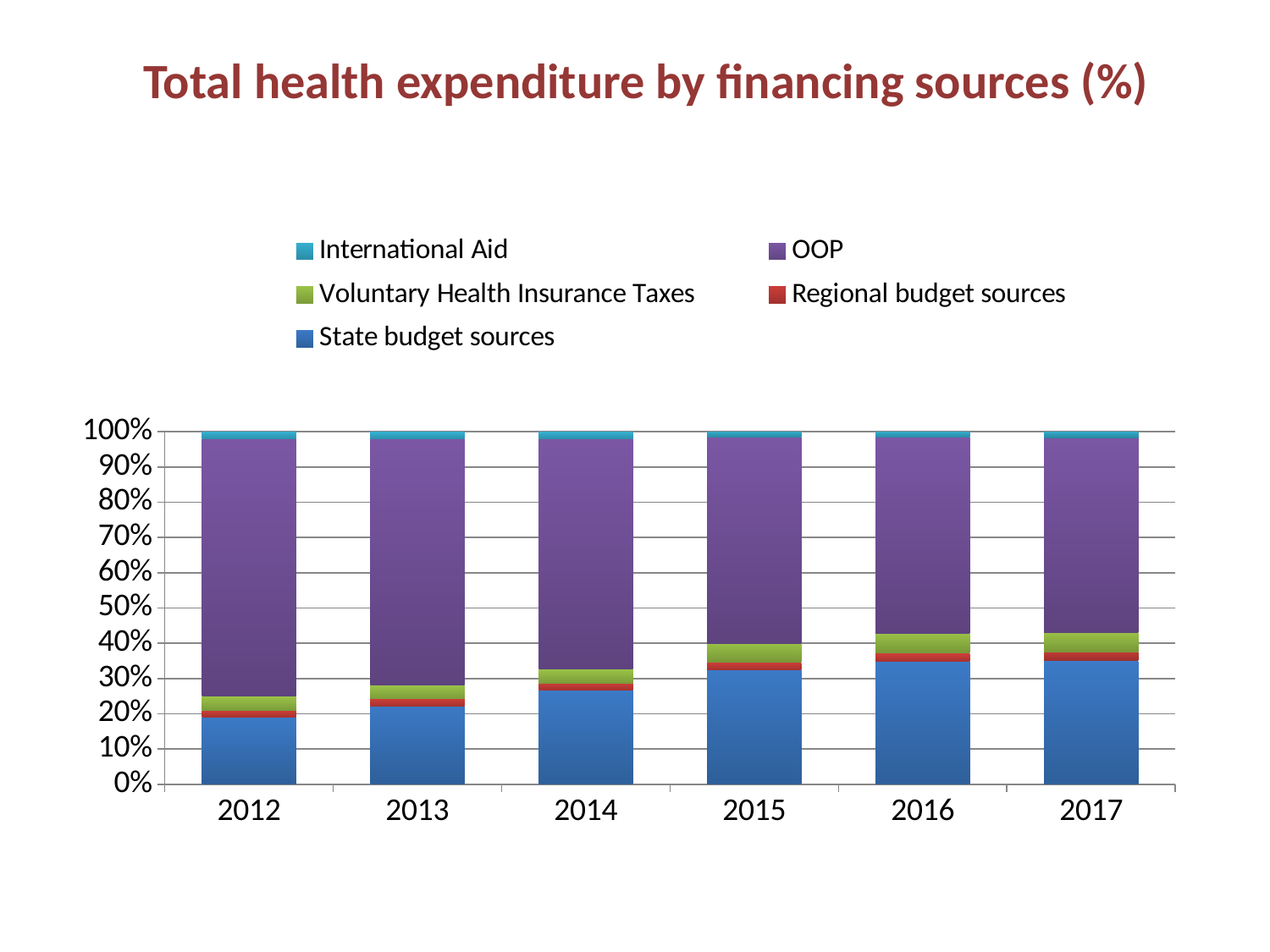
Which colour represents OOP in the chart? purple What kind of chart is shown on the slide? stacked bar chart Does the share of OOP rise or fall from 2012 to 2017? fall Which year has the smallest share of State budget sources? 2012 How many years are shown on the x axis of the chart? 6 Which is larger, the share of OOP in 2012 or in 2017? 2012 Is the share of State budget sources in 2012 greater or less than 30%? less How many series does the chart's legend list? 5 Does the share of State budget sources rise or fall from 2012 to 2017? rise Is the share of State budget sources in 2014 greater or less than 30%? less What is the title of the chart? Total health expenditure by financing sources (%) Is the share of State budget sources in 2017 greater or less than 30%? greater